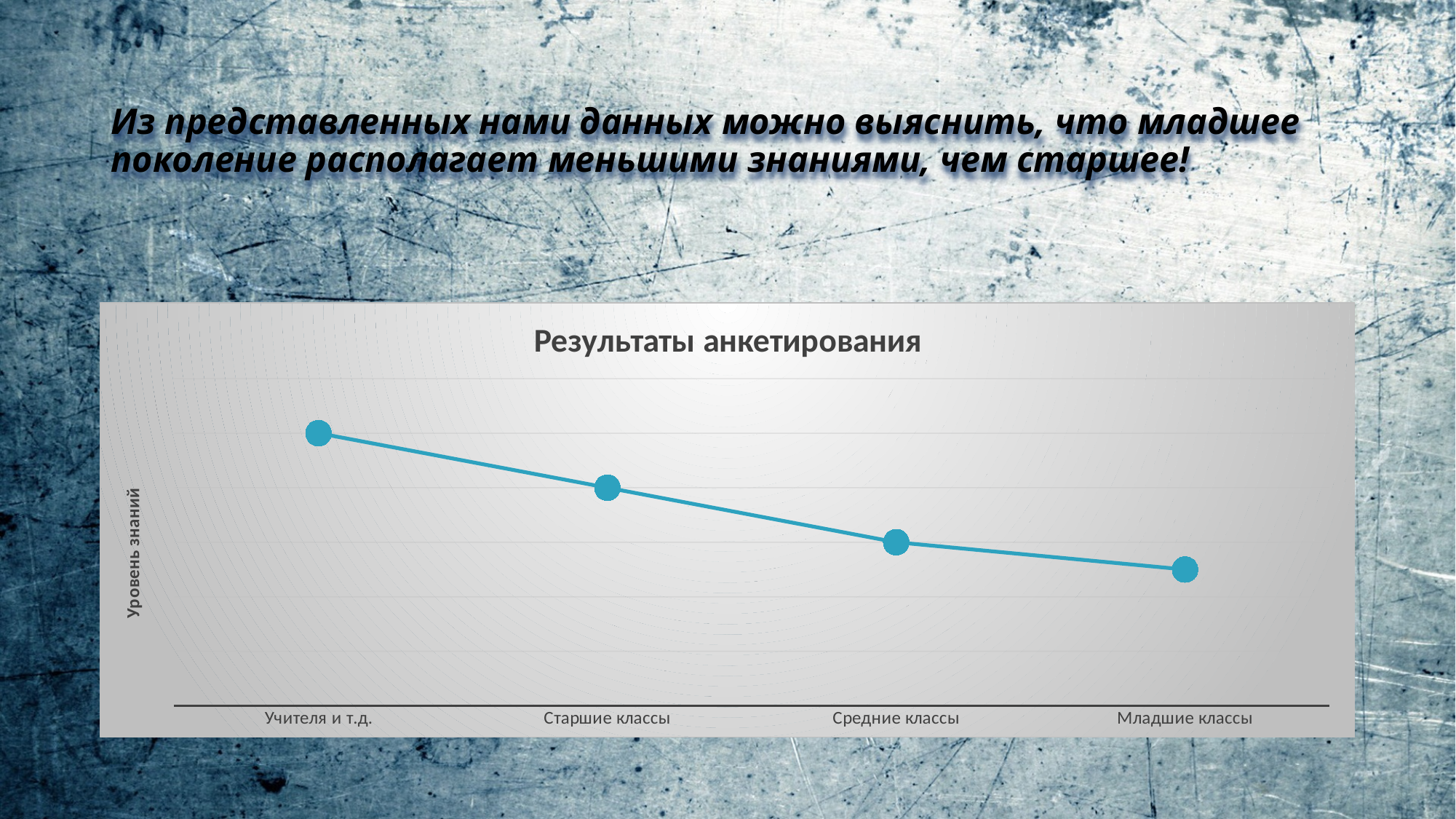
What is the title of the chart? Результаты анкетирования Do the values rise or fall from left to right along the x axis? Fall Which is larger, the value for Учителя и т.д. or the value for Младшие классы? Учителя и т.д. Which is larger, the value for Средние классы or the value for Младшие классы? Средние классы What is the label on the vertical axis of the chart? Уровень знаний Which category has the highest value on the chart? Учителя и т.д. How many data points are plotted on the chart? 4 What kind of chart is shown on the slide? Line chart Which is larger, the value for Старшие классы or the value for Средние классы? Старшие классы Which category has the lowest value on the chart? Младшие классы What is the first category on the x axis of the chart? Учителя и т.д.